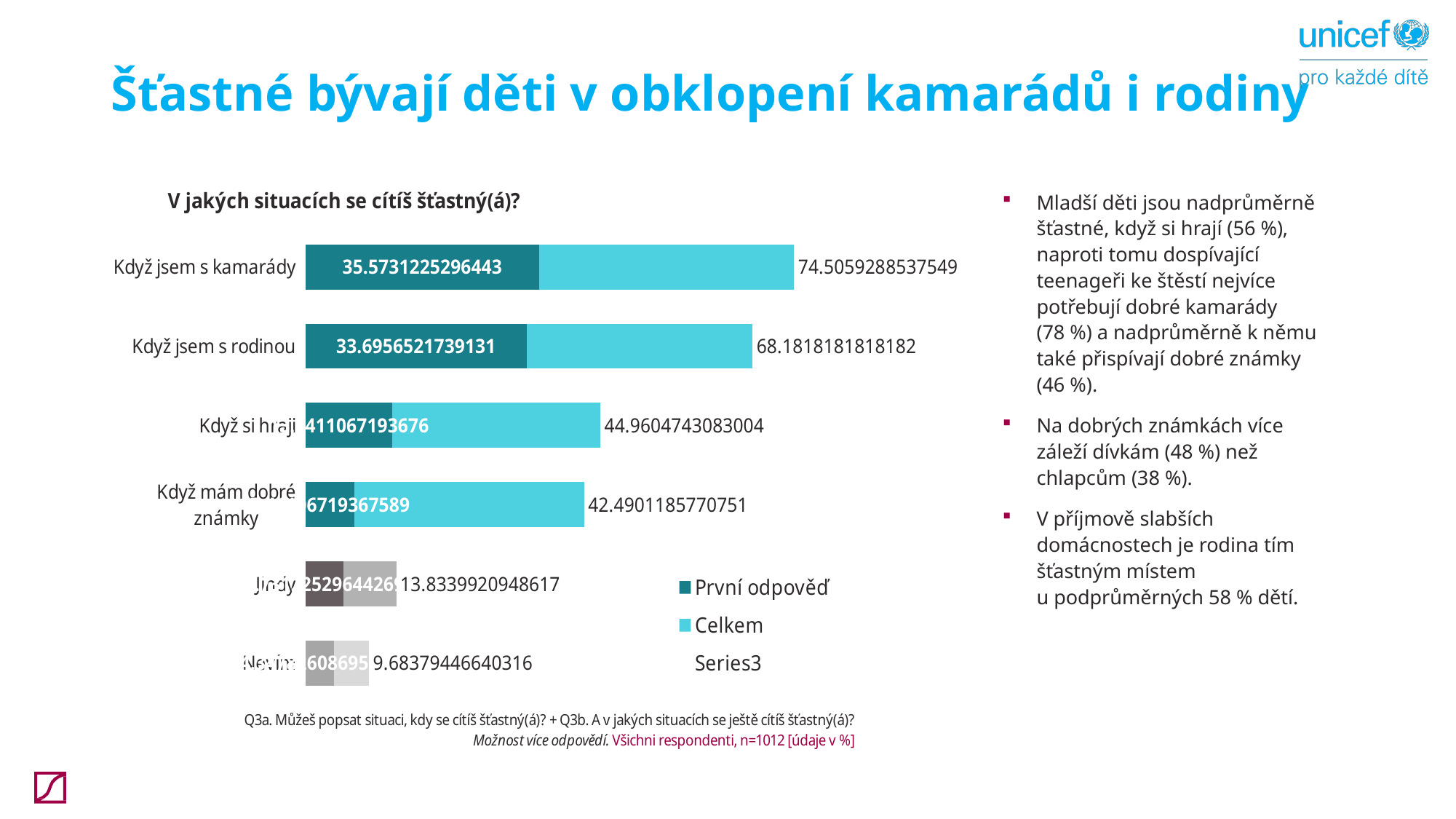
Which category has the lowest Celkem value? Nevím What is the První odpověď value for "Když jsem s rodinou"? 33.6956521739131 Which has a larger Celkem value, "Když si hraji" or "Když mám dobré známky"? Když mám dobré známky Which category has the highest Celkem value? Když jsem s kamarády How many categories are shown in the chart? 6 What is the První odpověď value for "Když jsem s kamarády"? 35.5731225296443 How many series does the legend list? 3